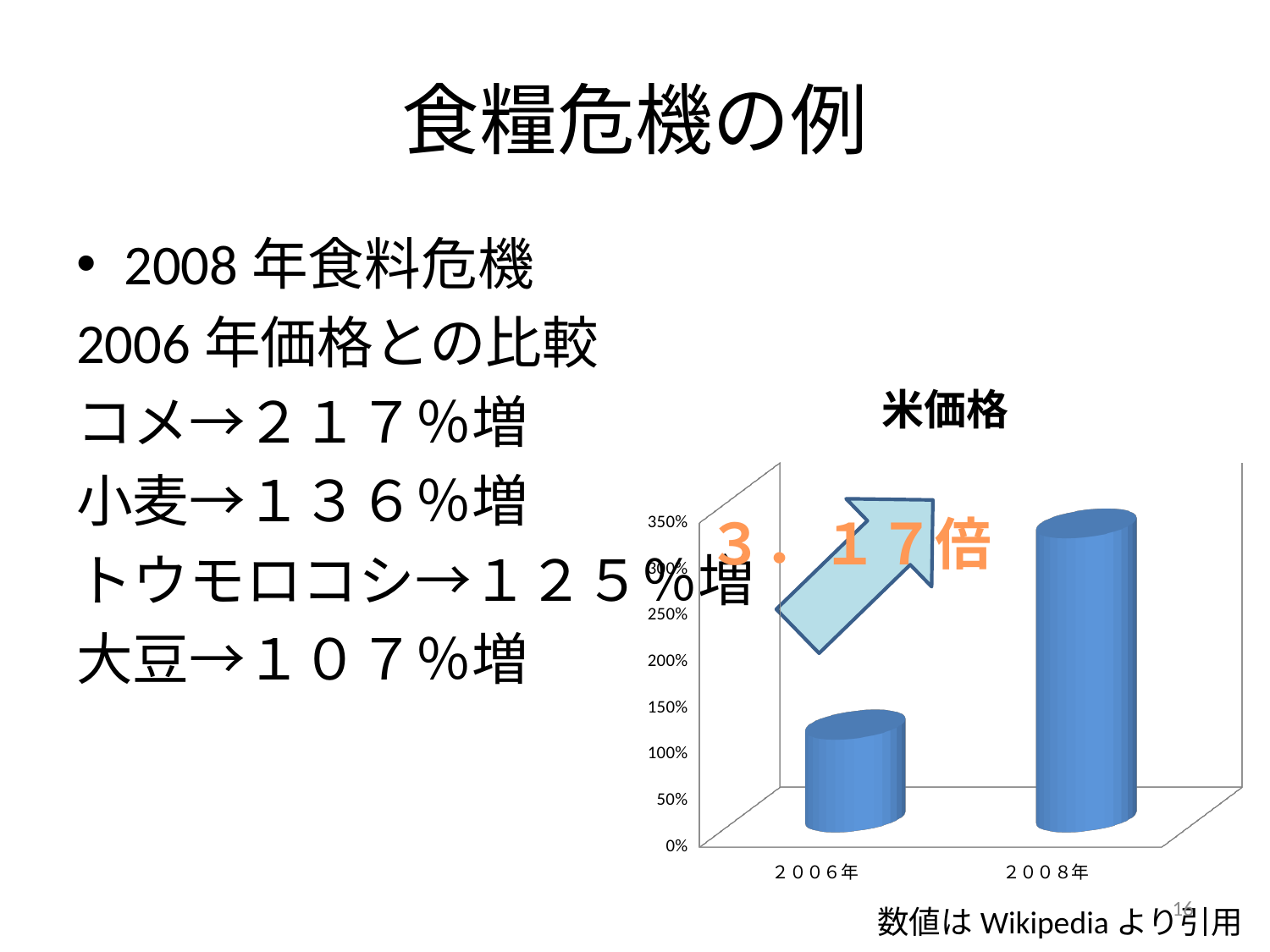
What is the highest tick label shown on the vertical axis of the chart? 350% What is the title of the chart? 米価格 How many categories are shown on the x axis of the chart? 2 Which category has the lowest value in the chart? ２００６年 Which category has the highest value in the chart? ２００８年 Is the value for ２００６年 greater or less than 50%? greater Do the values rise or fall from ２００６年 to ２００８年? rise Is the value for ２００６年 greater or less than 150%? less Which is larger, the value for ２００６年 or the value for ２００８年? ２００８年 What kind of chart is shown on the slide? bar chart Is the value for ２００８年 greater or less than 250%? greater